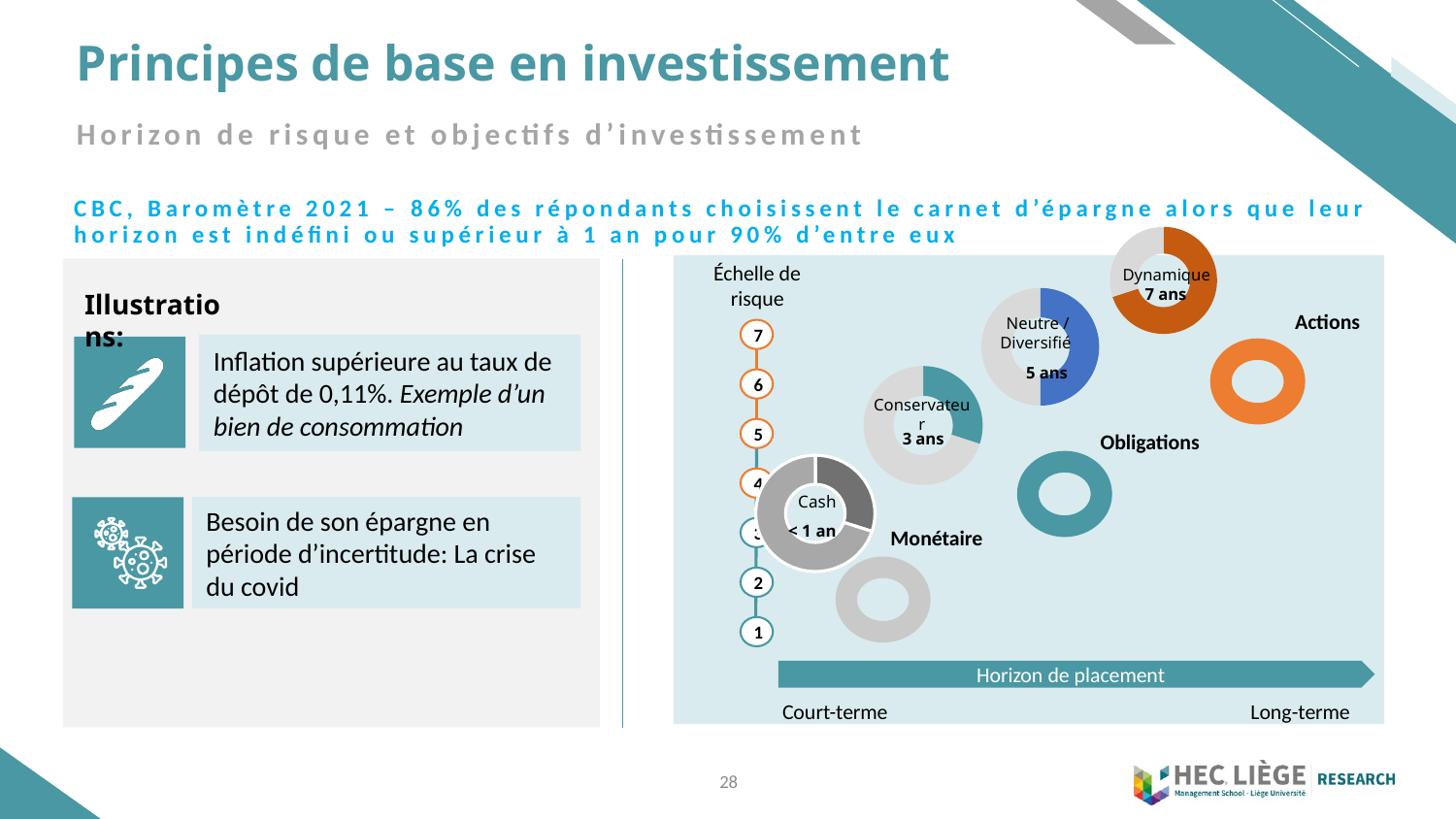
What investment horizon is shown for the Neutre / Diversifié profile? 5 ans What investment horizon is shown for the Dynamique profile? 7 ans Which has a longer investment horizon, Neutre / Diversifié or Conservateur? Neutre / Diversifié Does the risk level rise or fall as the investment horizon moves from Court-terme to Long-terme? rise How many years longer is the horizon of the Dynamique profile than that of the Conservateur profile? 4 ans Which profile has the longest investment horizon? Dynamique What investment horizon is shown for the Cash profile? < 1 an What investment horizon is shown for the Conservateur profile? 3 ans How many investor profiles with a stated horizon are shown on the diagram? 4 What label is shown on the horizontal axis arrow at the bottom of the diagram? Horizon de placement What is the highest level on the risk scale (Échelle de risque)? 7 Which profile has the shortest investment horizon? Cash